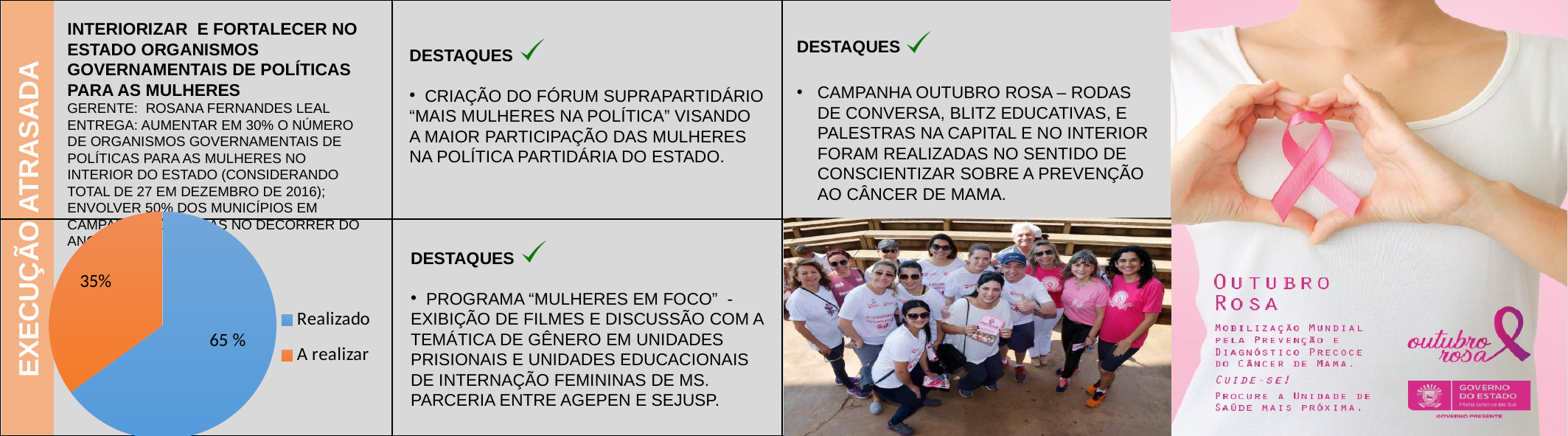
Which slice of the pie chart is the smallest? A realizar Which is larger in the pie chart, "Realizado" or "A realizar"? Realizado What colour is the "A realizar" slice in the pie chart? orange What is the difference in percentage points between the "Realizado" and "A realizar" slices? 30 What share of the pie does the "A realizar" slice represent? 35% How many entries does the pie chart's legend list? 2 What kind of chart is shown on the slide? pie chart What colour is the "Realizado" slice in the pie chart? blue What is the value shown for the "Realizado" slice of the pie chart? 65 % Which slice of the pie chart is the largest? Realizado How many slices does the pie chart have? 2 What is the value shown for the "A realizar" slice of the pie chart? 35%